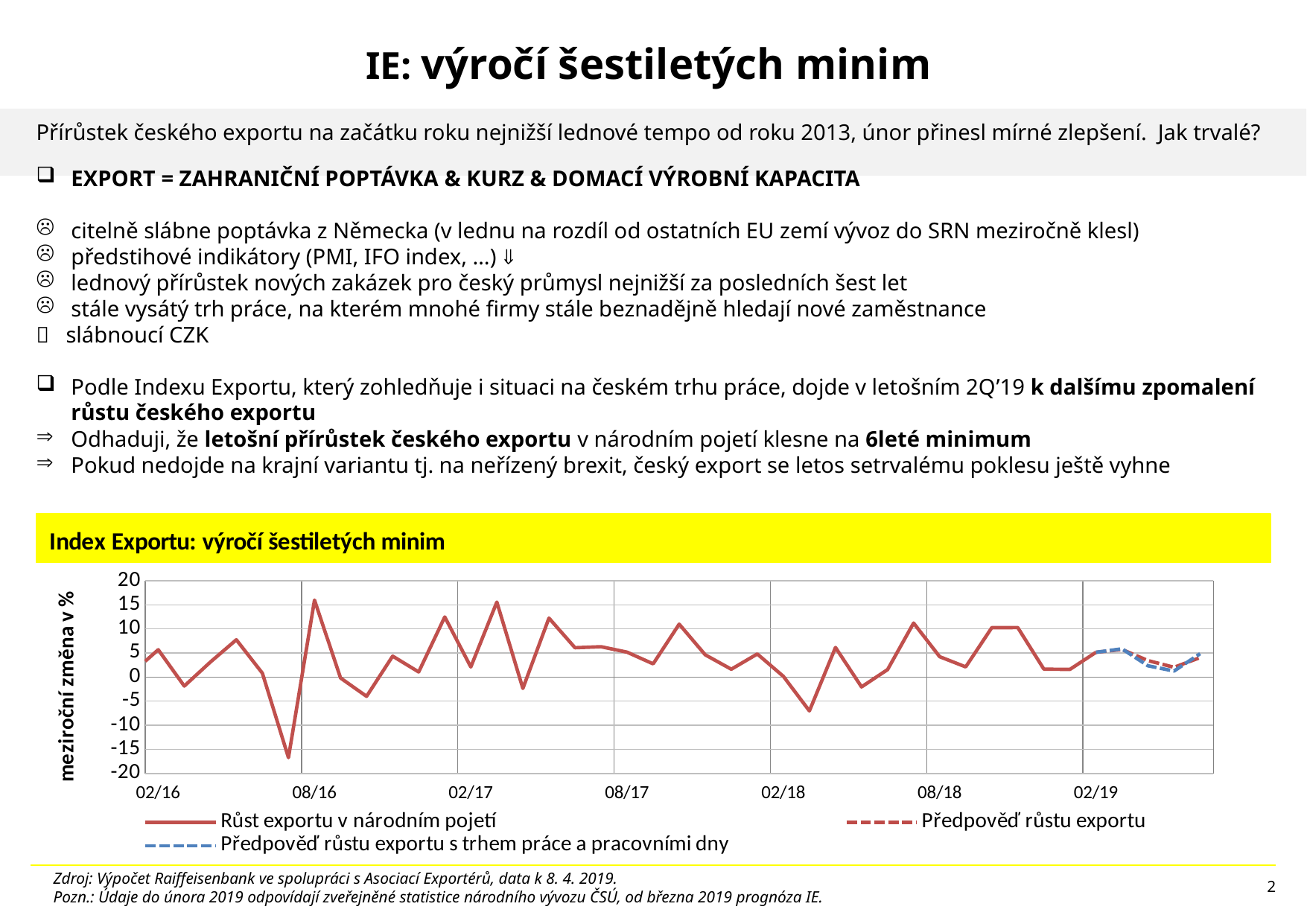
What is the label of the vertical axis of the chart? meziroční změna v % What is the highest tick value shown on the vertical axis of the chart? 20 Is the highest value of the series 'Růst exportu v národním pojetí' greater or less than 10? greater Is the value of 'Růst exportu v národním pojetí' at 02/18 greater or less than 5? less What is the title of the chart? Index Exportu: výročí šestiletých minim How many date labels are shown on the horizontal axis of the chart? 7 Is the lowest value of the series 'Růst exportu v národním pojetí' greater or less than -15? less How many series does the chart legend list? 3 What kind of chart is shown on the slide? line chart